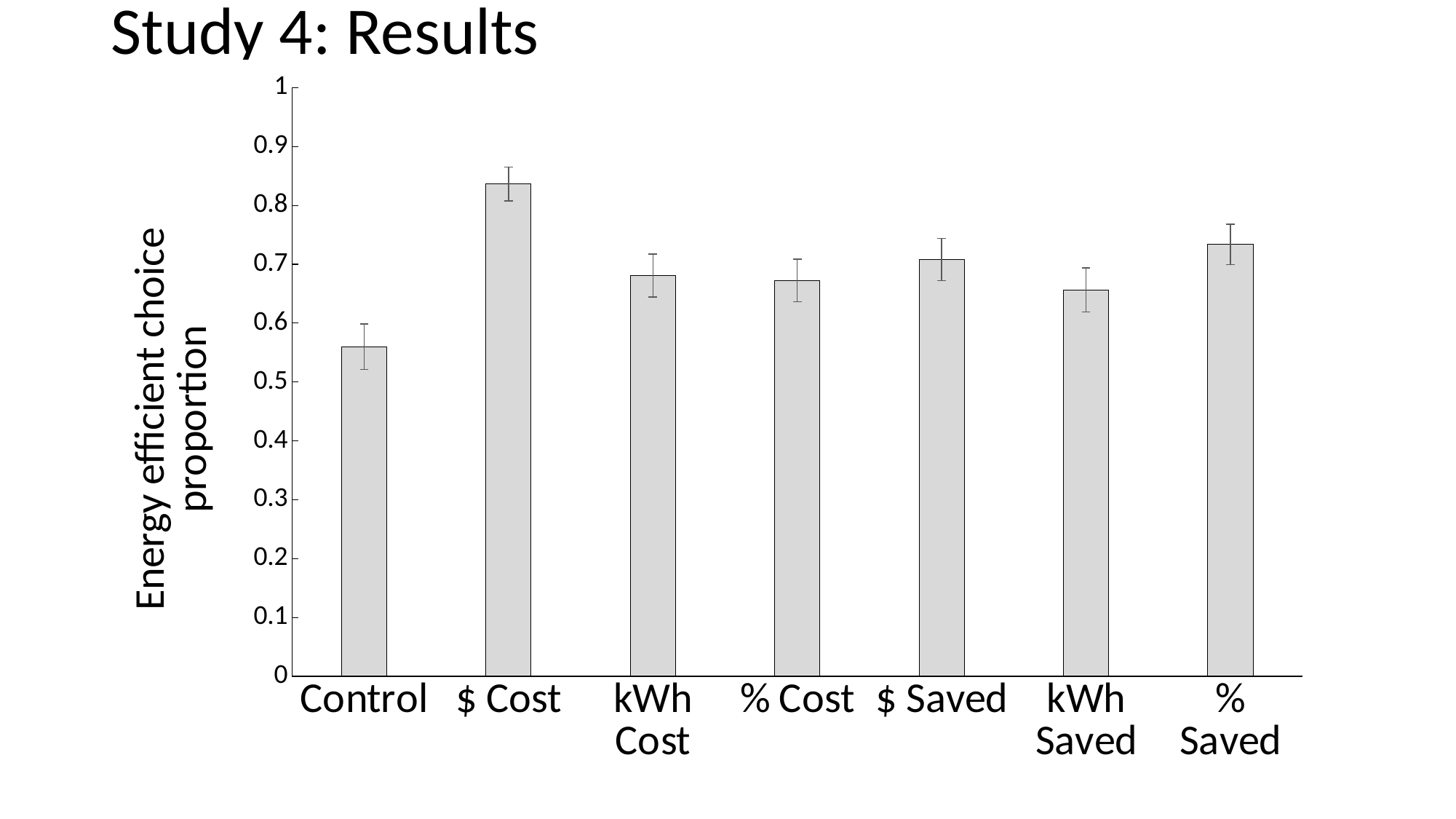
Is the value for kWh Saved greater or less than 0.7? less Which is larger, the value for Control or the value for kWh Saved? kWh Saved Which category has the highest energy efficient choice proportion? $ Cost Is the value for $ Cost greater or less than 0.8? greater Is the value for % Saved greater or less than 0.8? less What kind of chart is shown on the slide? bar chart Which is larger, the value for $ Cost or the value for % Saved? $ Cost What is the label on the y axis? Energy efficient choice proportion Which category has the lowest energy efficient choice proportion? Control How many categories are shown on the x axis? 7